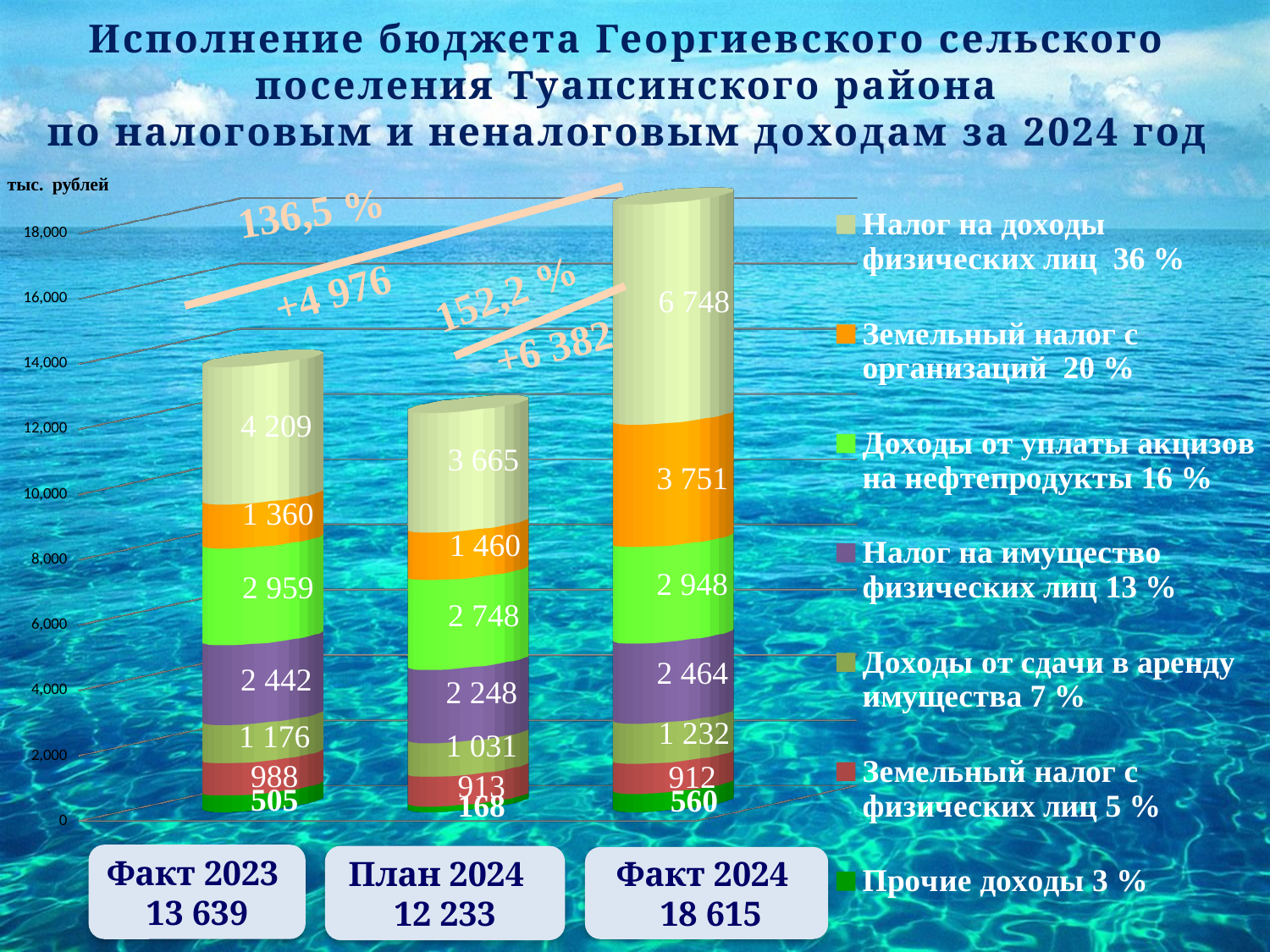
What is the value of Налог на доходы физических лиц for Факт 2024? 6 748 Which bar has the lowest total? План 2024 How many bars (categories) are plotted on the chart? 3 Which is larger: Доходы от уплаты акцизов на нефтепродукты for Факт 2023 or for План 2024? Факт 2023 What is the total of the Факт 2024 bar? 18 615 What is the value of Прочие доходы for Факт 2023? 505 What is the difference between the Факт 2024 total and the Факт 2023 total? 4 976 What is the value of Земельный налог с организаций for План 2024? 1 460 What share of revenue does the legend give for Налог на имущество физических лиц? 13 % How many series does the legend list? 7 What kind of chart is shown on the slide? stacked bar chart Which bar has the highest total? Факт 2024